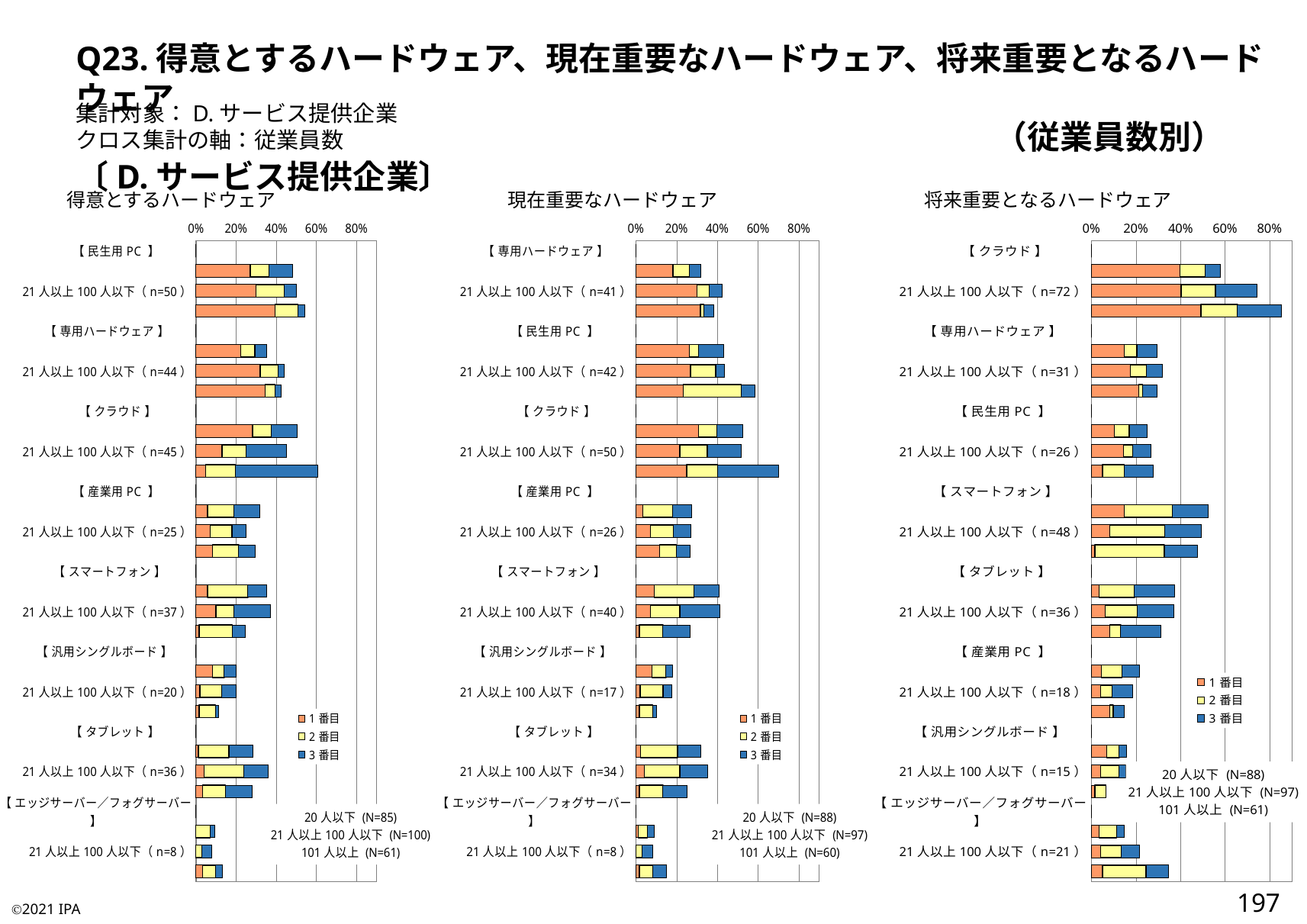
In the 現在重要なハードウェア chart, is the total for 汎用シングルボード for 101人以上 greater or less than 20%? less In the 将来重要となるハードウェア chart, which hardware category has the longest bar? クラウド What are the legend entries of the 将来重要となるハードウェア chart? 1番目, 2番目, 3番目 In the 得意とするハードウェア chart, which is larger for 20人以下: the total for 専用ハードウェア or the total for 汎用シングルボード? 専用ハードウェア What is the title of the rightmost chart on the slide? 将来重要となるハードウェア In the 将来重要となるハードウェア chart, which is larger for 21人以上100人以下: the total for クラウド or the total for 専用ハードウェア? クラウド In the 将来重要となるハードウェア chart, is the total for クラウド for 101人以上 greater or less than 80%? greater In the 得意とするハードウェア chart, is the total for 民生用PC for 20人以下 greater or less than 40%? greater How many hardware categories are shown in the 得意とするハードウェア chart? 8 How many series does the legend of the 現在重要なハードウェア chart list? 3 What kind of chart is used for 得意とするハードウェア on the left of the slide? Stacked bar chart